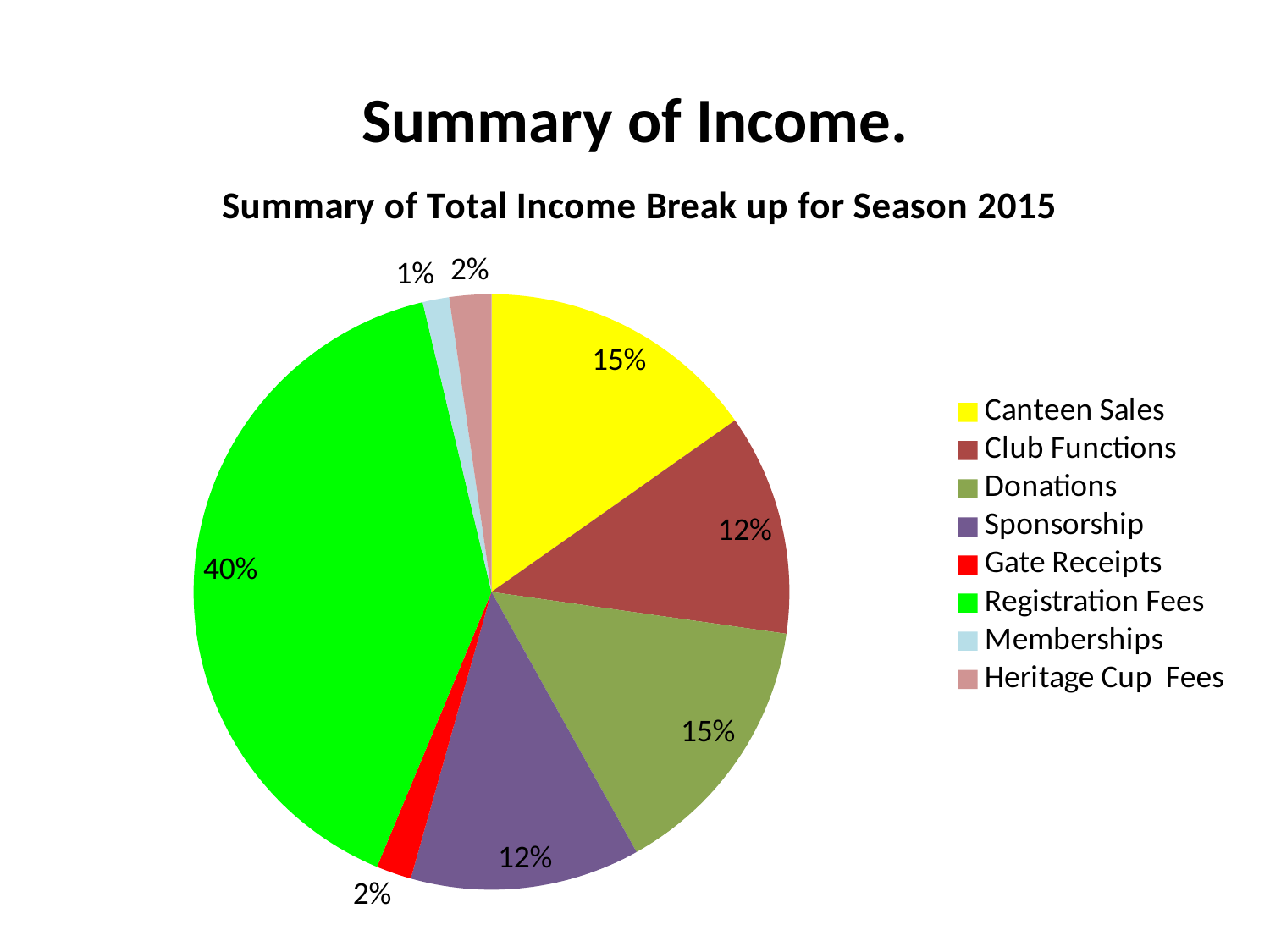
What share of total income comes from Gate Receipts? 2% Which income category has the largest share of the pie? Registration Fees What share of total income comes from Memberships? 1% What is the title of the chart? Summary of Total Income Break up for Season 2015 Which is larger, the share for Sponsorship or the share for Heritage Cup Fees? Sponsorship How many categories does the legend list? 8 What type of chart is shown on the slide? pie chart What share of total income comes from Canteen Sales? 15% What is the difference in percentage points between Registration Fees and Donations? 25 Which income category has the smallest share of the pie? Memberships